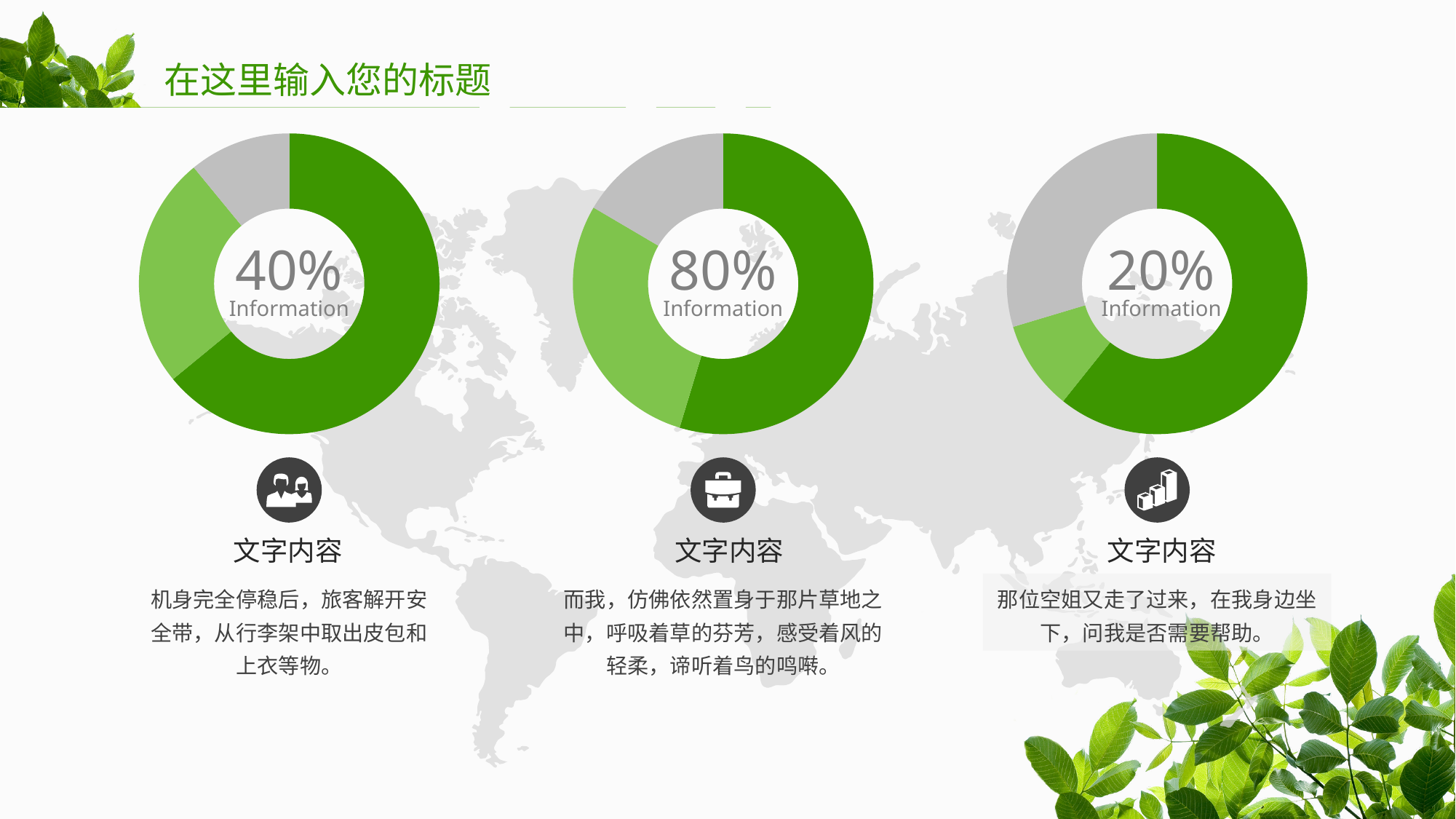
Which is larger, the centre percentage of the left donut chart or the right donut chart? The left chart (40%) What is the difference between the centre percentages of the left and right donut charts? 20% How many slices does each donut chart contain? 3 Which donut chart shows the highest centre percentage? The middle chart (80%) What percentage is printed in the centre of the right donut chart? 20% What percentage is printed in the centre of the left donut chart? 40% How many donut charts are on the slide? 3 What word is printed beneath the percentage in the centre of each donut chart? Information What kind of chart is shown three times on this slide? Donut (pie) chart What is the difference between the centre percentages of the middle and right donut charts? 60% What percentage is printed in the centre of the middle donut chart? 80% Which donut chart shows the lowest centre percentage? The right chart (20%)